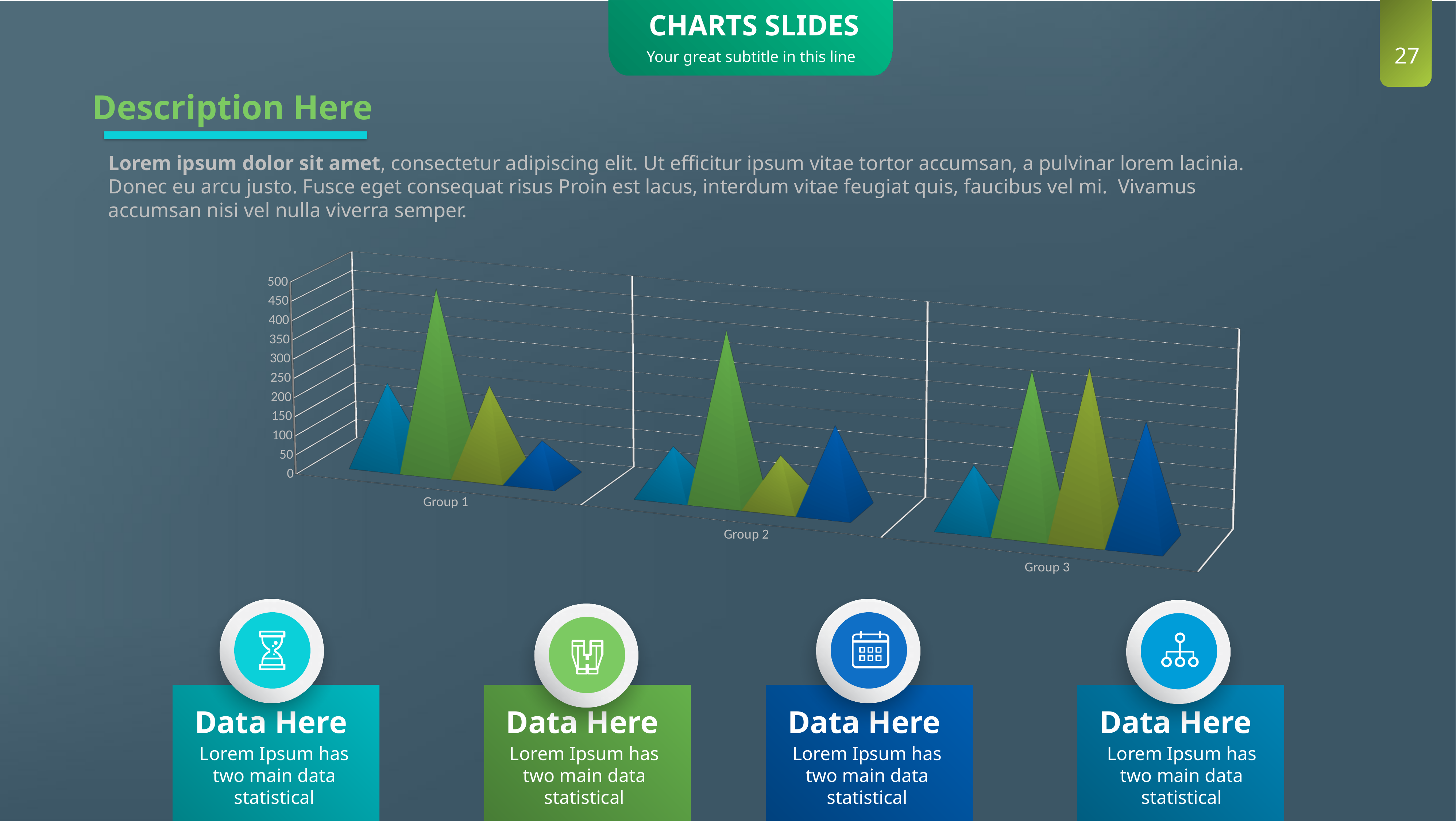
What kind of chart is shown on the slide? bar chart In Group 3, which is larger: the dark blue pyramid or the teal pyramid? dark blue How many groups (categories) are shown on the x axis of the chart? 3 What is the interval between consecutive tick marks on the chart's vertical axis? 50 What is the highest value shown on the chart's vertical axis? 500 Is the value of the green pyramid in Group 1 greater or less than 300? greater In Group 3, which colour pyramid is the shortest? teal Is the value of the dark blue pyramid in Group 1 greater or less than 200? less How many pyramids (bars) are plotted in each group of the chart? 4 In Group 1, which colour pyramid is the shortest? dark blue In Group 1, which colour pyramid is the tallest? green In Group 2, which colour pyramid is the tallest? green